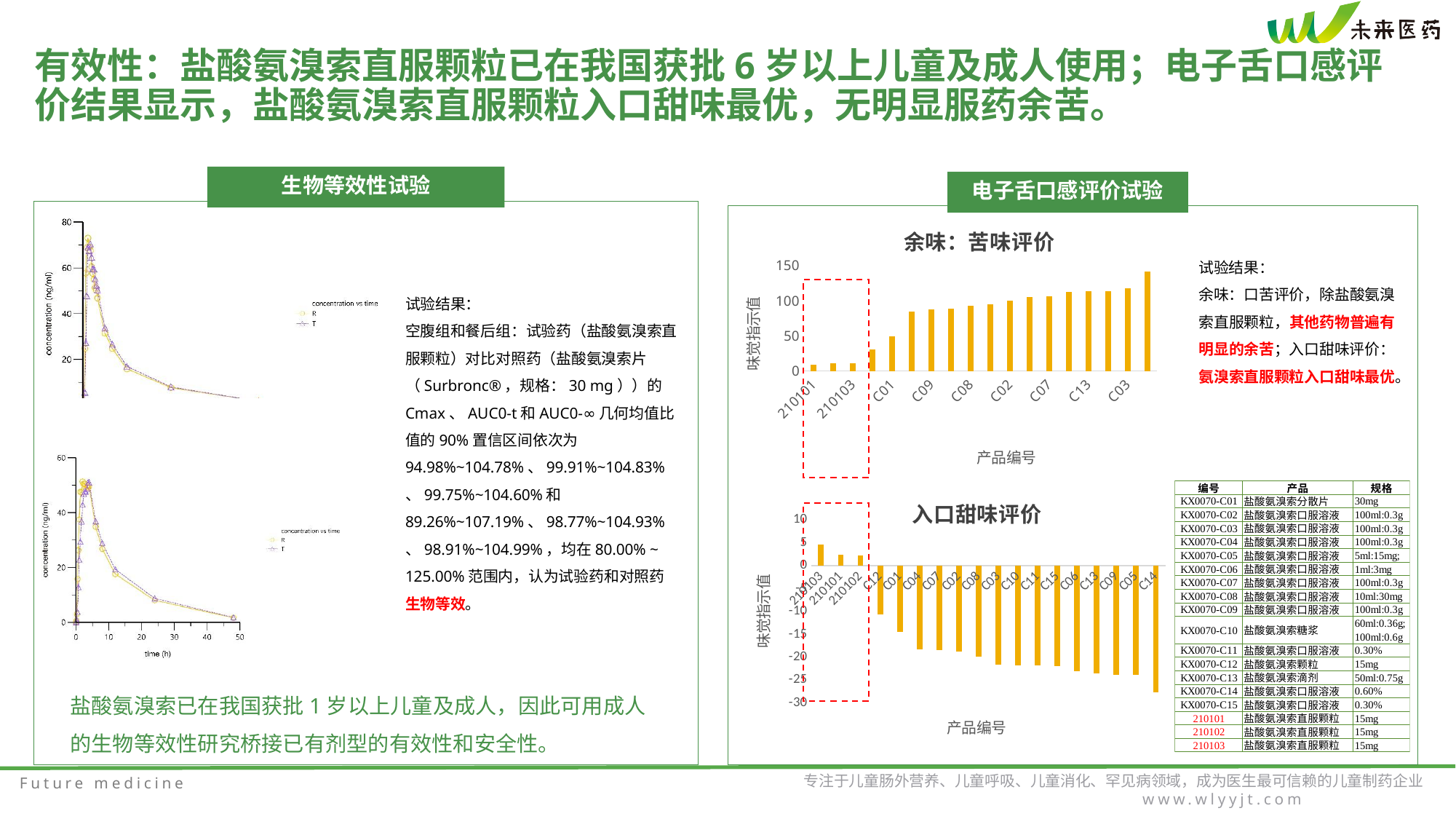
What kind of chart is the "余味：苦味评价" chart? bar chart What kind of chart is the "入口甜味评价" chart? bar chart In the "余味：苦味评价" chart, is the value for 210101 greater or less than 50? less In the "入口甜味评价" chart, which category has the lowest value? C14 In the "余味：苦味评价" chart, is the value for 210103 greater or less than 50? less In the "入口甜味评价" chart, is the value for 210103 greater or less than 0? greater How many categories are shown on the x axis of the "入口甜味评价" chart? 18 In the "入口甜味评价" chart, which category has the highest value? 210103 In the "入口甜味评价" chart, which has the larger value, 210103 or C12? 210103 How many series does the legend of the top-left concentration vs time chart list? 2 In the "余味：苦味评价" chart, do the values generally rise or fall from left to right along the x axis? rise